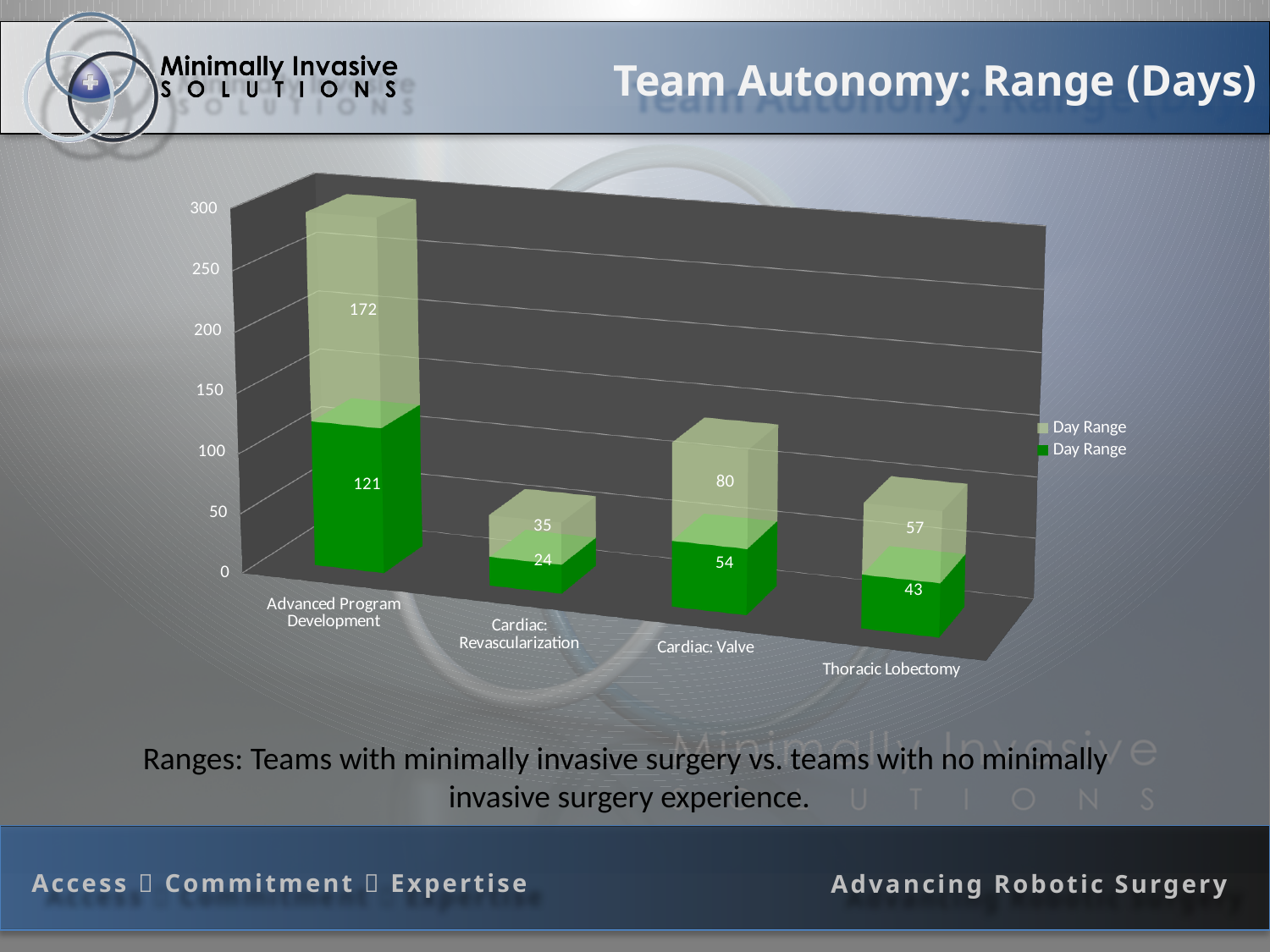
What is the value of the light green (top) segment for Cardiac: Revascularization? 35 What is the value of the dark green (bottom) segment for Advanced Program Development? 121 How many series does the chart legend list? 2 Which category has the shortest stacked bar? Cardiac: Revascularization What type of chart is shown on the slide? Stacked bar chart How many categories are shown on the x axis of the chart? 4 What is the difference between the light green and dark green segments for Advanced Program Development? 51 What is the value of the dark green (bottom) segment for Thoracic Lobectomy? 43 Is the dark green (bottom) segment larger for Cardiac: Valve or for Thoracic Lobectomy? Cardiac: Valve What is the value of the light green (top) segment for Cardiac: Valve? 80 What is the total of the stacked bar for Cardiac: Valve? 134 Which category has the tallest stacked bar? Advanced Program Development